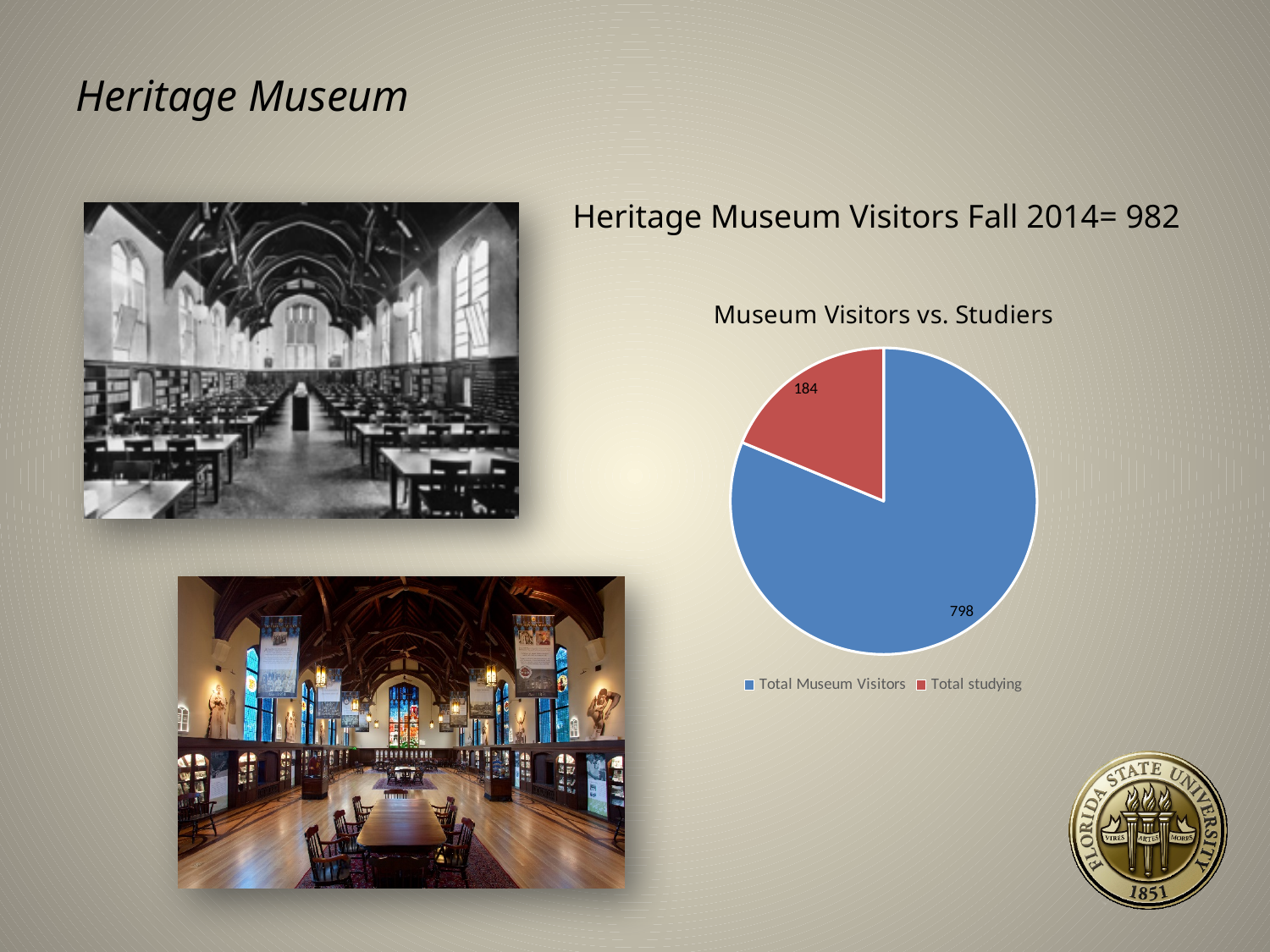
What is the value for Total Museum Visitors in the pie chart? 798 Which is larger, Total Museum Visitors or Total studying? Total Museum Visitors What is the title of the chart? Museum Visitors vs. Studiers What is the total of the two values shown in the pie chart? 982 Which slice of the pie chart is the smallest? Total studying What type of chart is shown on the slide? pie chart What is the difference between Total Museum Visitors and Total studying? 614 How many entries does the chart legend list? 2 What is the value for Total studying in the pie chart? 184 How many slices does the pie chart have? 2 Which slice of the pie chart is the largest? Total Museum Visitors What colour is the Total studying slice in the pie chart? red